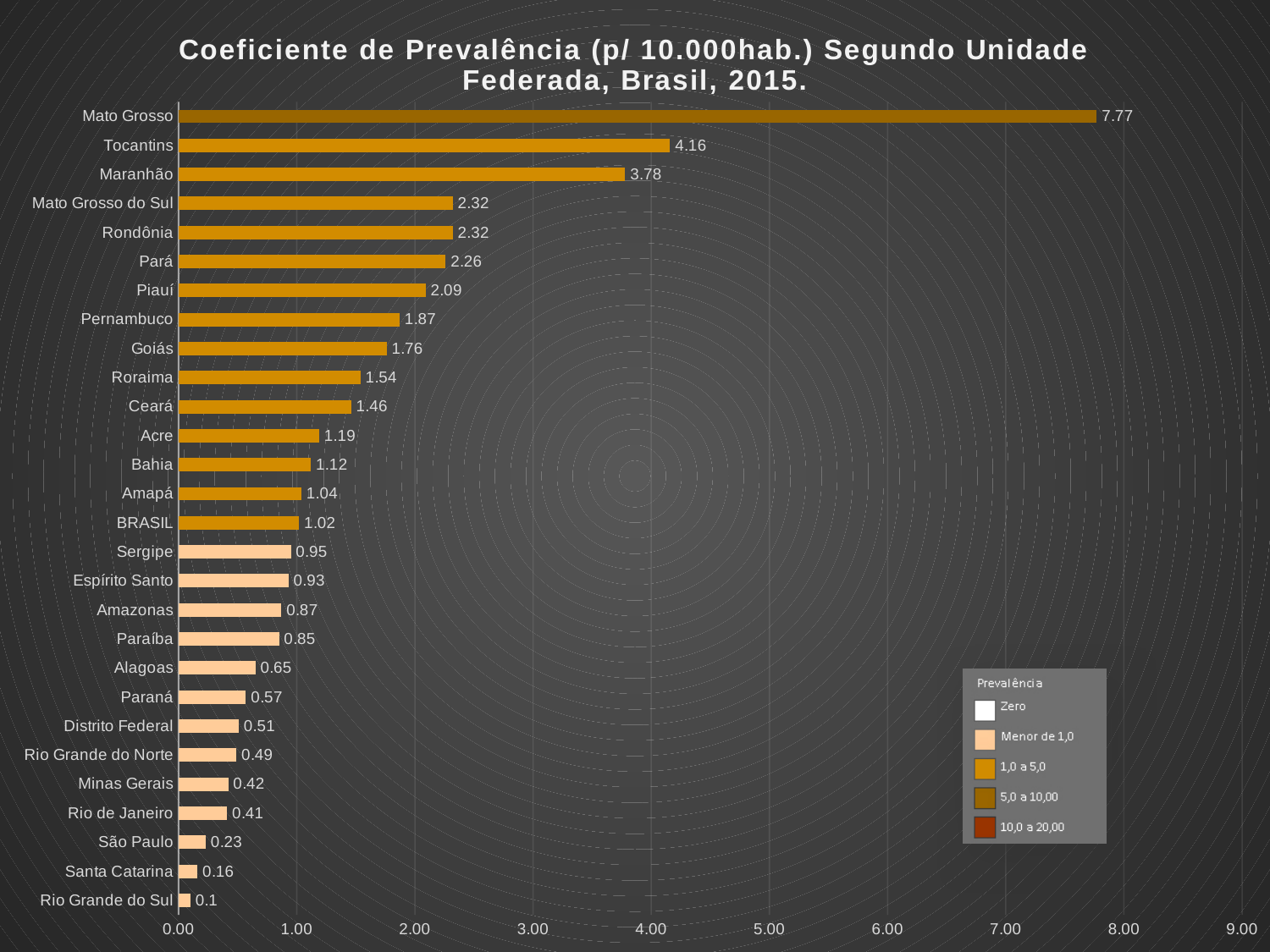
Which unit has the lowest coefficient? Rio Grande do Sul How many categories does the legend list? 5 What kind of chart is shown? Bar chart What is the value for BRASIL? 1.02 What is the title of the legend box? Prevalência Which unit has the highest coefficient? Mato Grosso What is the difference between the values for Tocantins and Maranhão? 0.38 What is the value for Pernambuco? 1.87 How many bars (units) are shown in the chart? 28 What is the value for Mato Grosso? 7.77 Which is larger, the value for Piauí or the value for Goiás? Piauí Is the value for Tocantins greater or less than 4.00? greater